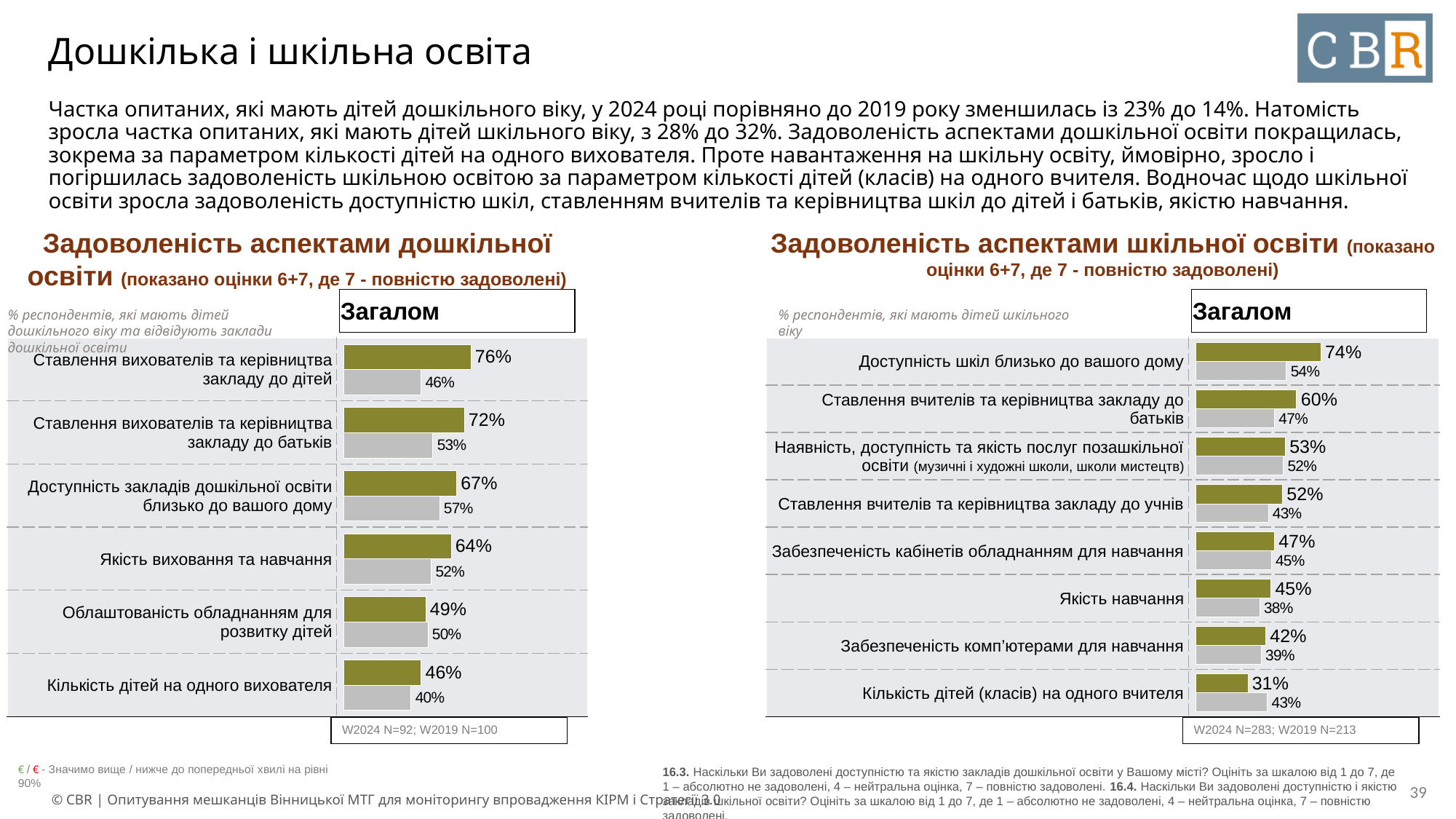
In the left chart (Задоволеність аспектами дошкільної освіти), what is the value of the grey (lower) bar for 'Кількість дітей на одного вихователя'? 40% In the right chart (Задоволеність аспектами шкільної освіти), what is the value of the olive (upper) bar for 'Доступність шкіл близько до вашого дому'? 74% In the left chart (Задоволеність аспектами дошкільної освіти), for 'Облаштованість обладнанням для розвитку дітей', which bar is larger: the olive bar or the grey bar? the grey bar In the left chart (Задоволеність аспектами дошкільної освіти), which category has the highest olive (upper) bar value? Ставлення вихователів та керівництва закладу до дітей In the left chart (Задоволеність аспектами дошкільної освіти), how many categories are shown? 6 In the right chart (Задоволеність аспектами шкільної освіти), which category has the lowest olive (upper) bar value? Кількість дітей (класів) на одного вчителя In the right chart (Задоволеність аспектами шкільної освіти), what is the value of the grey (lower) bar for 'Кількість дітей (класів) на одного вчителя'? 43% In the left chart (Задоволеність аспектами дошкільної освіти), what is the difference between the olive and grey bars for 'Ставлення вихователів та керівництва закладу до дітей'? 30 percentage points What type of chart is used on the right side of the slide (Задоволеність аспектами шкільної освіти)? bar chart In the right chart (Задоволеність аспектами шкільної освіти), what is the difference between the olive and grey bars for 'Якість навчання'? 7 percentage points In the left chart (Задоволеність аспектами дошкільної освіти), what is the value of the olive (upper) bar for 'Ставлення вихователів та керівництва закладу до дітей'? 76% In the right chart (Задоволеність аспектами шкільної освіти), how many categories are shown? 8